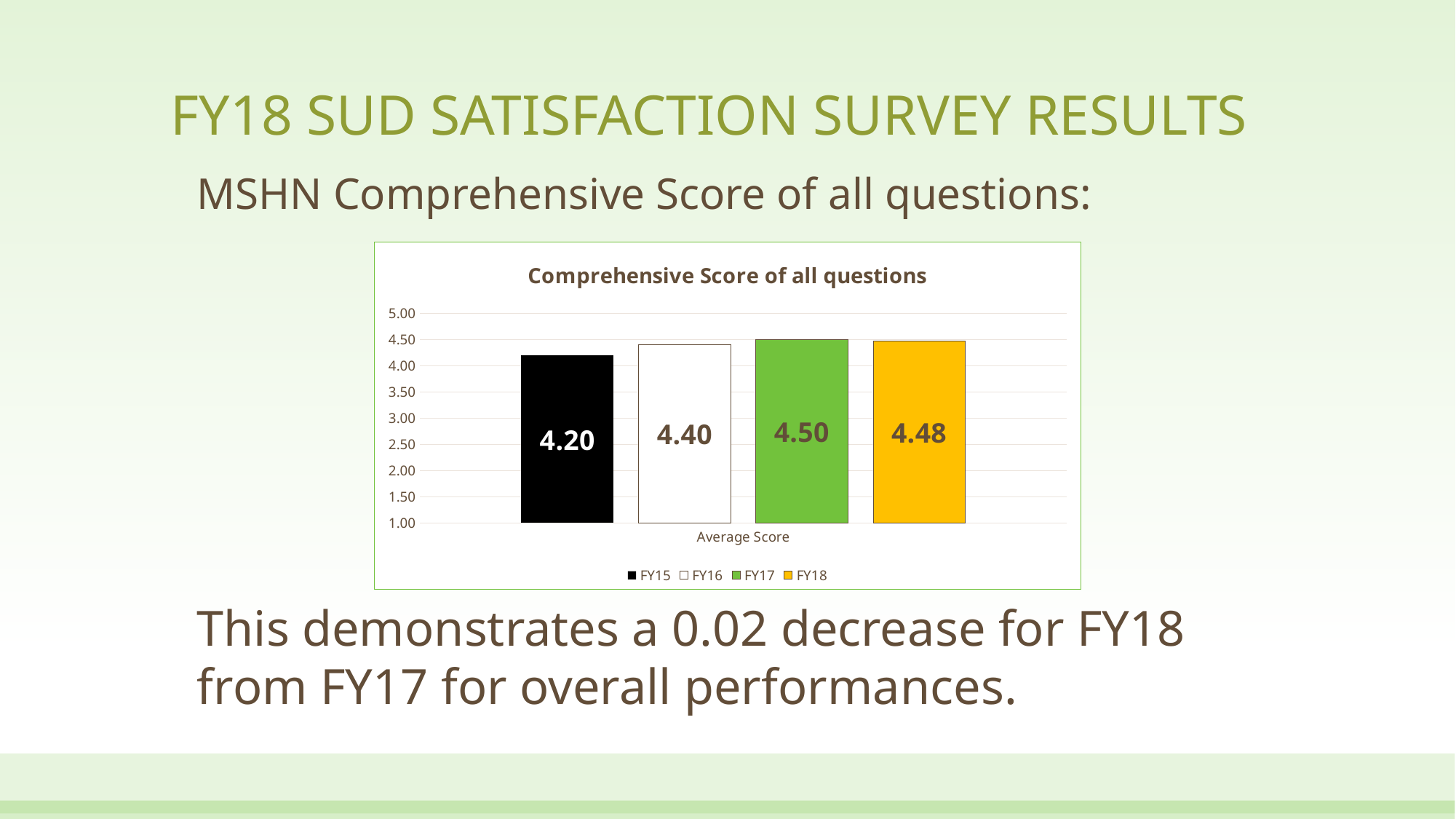
Which fiscal year has the lowest average score? FY15 What is the title of the chart? Comprehensive Score of all questions Which is larger, the FY16 score or the FY18 score? FY18 How many series does the legend list? 4 What is the difference between the FY16 and FY15 average scores? 0.20 Which fiscal year has the highest average score? FY17 What is the average score for FY17? 4.50 What is the difference between the FY17 and FY18 average scores? 0.02 What is the average score for FY15? 4.20 What is the average score for FY18? 4.48 What kind of chart is shown on the slide? Bar chart What is the average score for FY16? 4.40